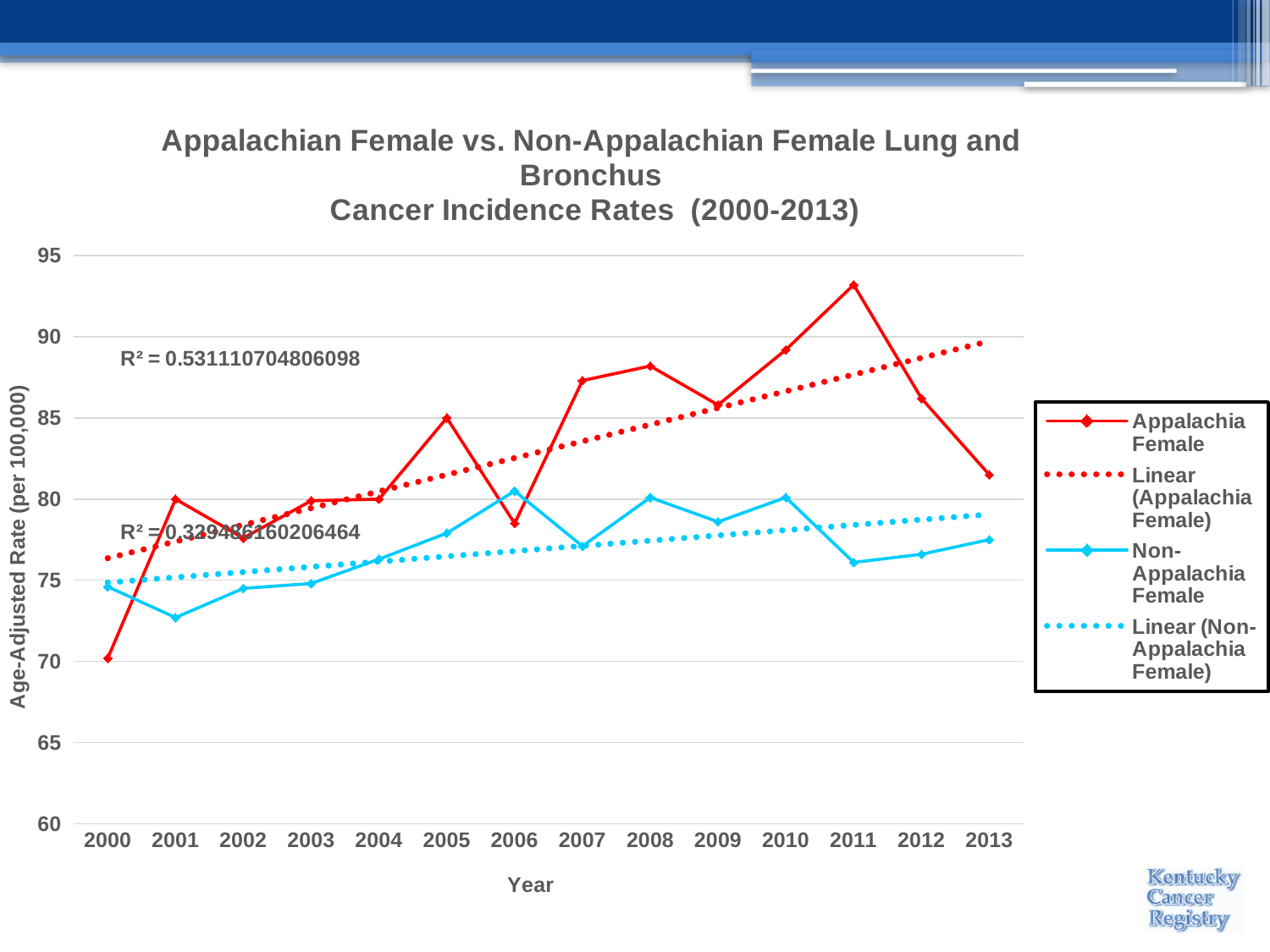
Is the Appalachia Female value for 2000 greater or less than 75? less In which year is the Appalachia Female incidence rate lowest? 2000 In which year is the Appalachia Female incidence rate highest? 2011 Does the Linear (Appalachia Female) trend line rise or fall from 2000 to 2013? rise How many years are plotted along the x axis? 14 What kind of chart is shown on the slide? line chart What is the R² value shown for the Appalachia Female trend line? 0.531110704806098 Is the Appalachia Female value for 2011 greater or less than 90? greater Is the Non-Appalachia Female value for 2001 greater or less than 75? less In which year is the Non-Appalachia Female incidence rate lowest? 2001 In 2013, which series has the higher value, Appalachia Female or Non-Appalachia Female? Appalachia Female How many entries does the legend list? 4